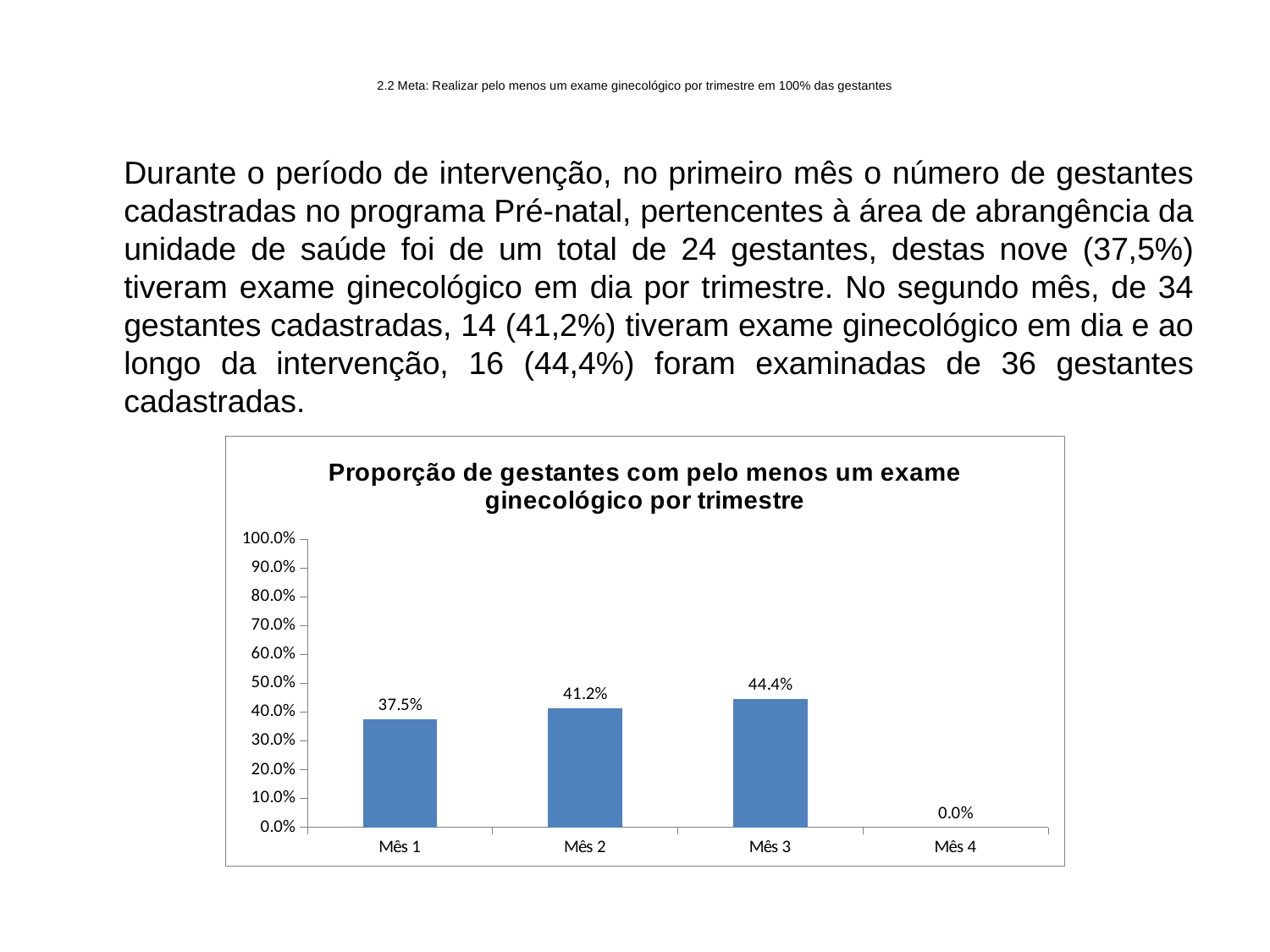
Is the value for Mês 3 greater or less than 50.0%? less What kind of chart is shown? bar chart Which is larger, the value for Mês 2 or the value for Mês 1? Mês 2 How many months are shown on the x axis? 4 What is the difference between the values for Mês 3 and Mês 1? 6.9% What is the value for Mês 4? 0.0% What is the value for Mês 2? 41.2% Which month has the lowest value? Mês 4 Which month has the highest value? Mês 3 What is the value for Mês 3? 44.4% What is the value for Mês 1? 37.5% What is the title of the chart? Proporção de gestantes com pelo menos um exame ginecológico por trimestre